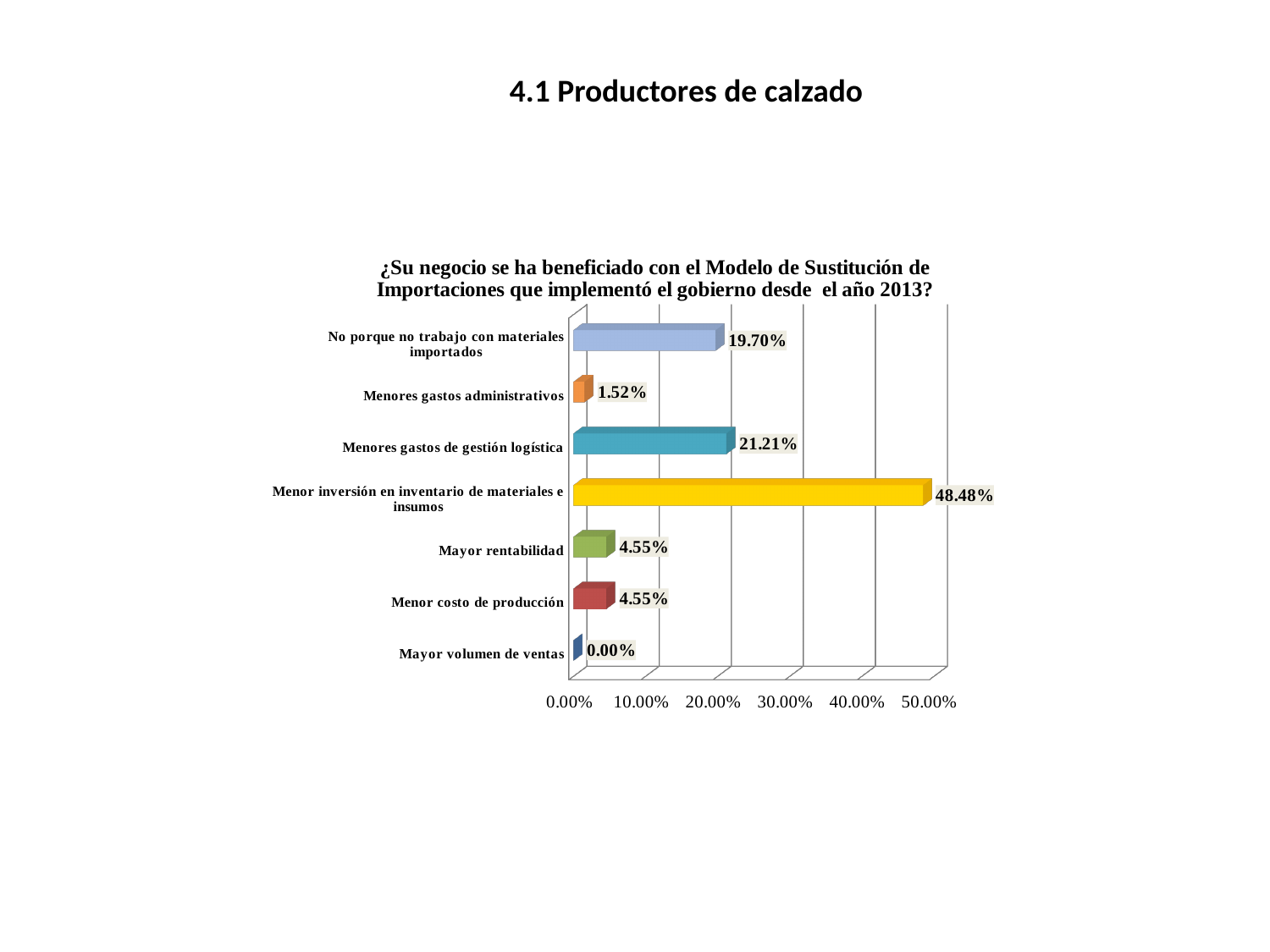
Which is larger, "Menores gastos de gestión logística" or "No porque no trabajo con materiales importados"? Menores gastos de gestión logística Which category has the highest value? Menor inversión en inventario de materiales e insumos What is the value for "Menor inversión en inventario de materiales e insumos"? 48.48% How many categories are shown in the chart? 7 What is the value for "Menores gastos de gestión logística"? 21.21% What is the difference between "Menor inversión en inventario de materiales e insumos" and "Menores gastos de gestión logística"? 27.27% What kind of chart is shown on the slide? Bar chart What is the value for "No porque no trabajo con materiales importados"? 19.70% Which category has the lowest value? Mayor volumen de ventas What is the title of the chart? ¿Su negocio se ha beneficiado con el Modelo de Sustitución de Importaciones que implementó el gobierno desde el año 2013? What is the value for "Mayor volumen de ventas"? 0.00% What is the value for "Menores gastos administrativos"? 1.52%